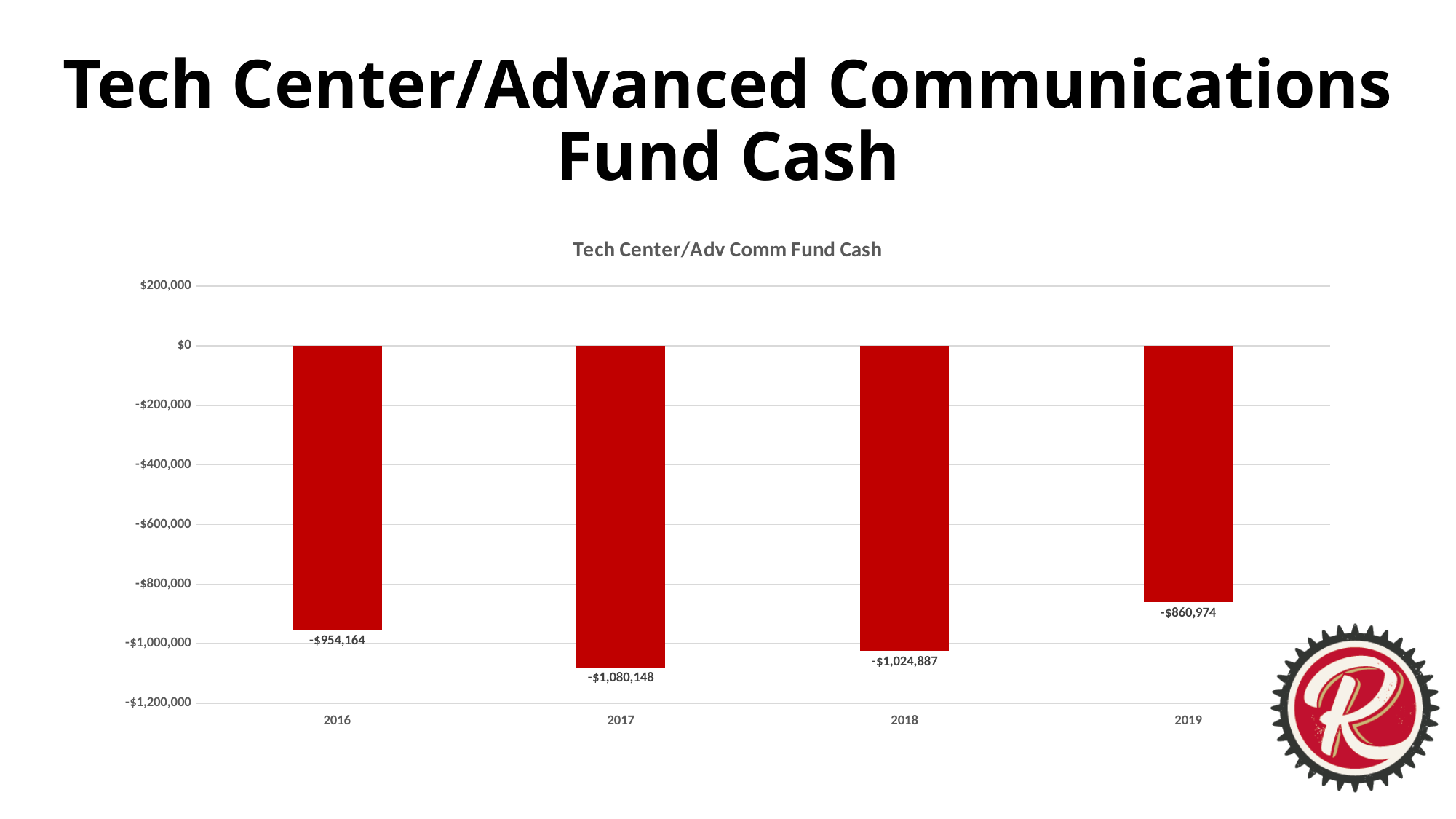
What is the value for 2019? -$860,974 Which year has a larger (less negative) value, 2016 or 2018? 2016 What is the value for 2016? -$954,164 Which year has the highest (least negative) fund cash value? 2019 What is the value for 2018? -$1,024,887 What is the value for 2017? -$1,080,148 What is the title of the chart? Tech Center/Adv Comm Fund Cash How many years are shown on the x axis? 4 What is the difference between the 2016 value and the 2017 value? $125,984 What kind of chart is shown on the slide? Bar chart What is the difference between the 2018 value and the 2019 value? $163,913 Which year has the lowest (most negative) fund cash value? 2017